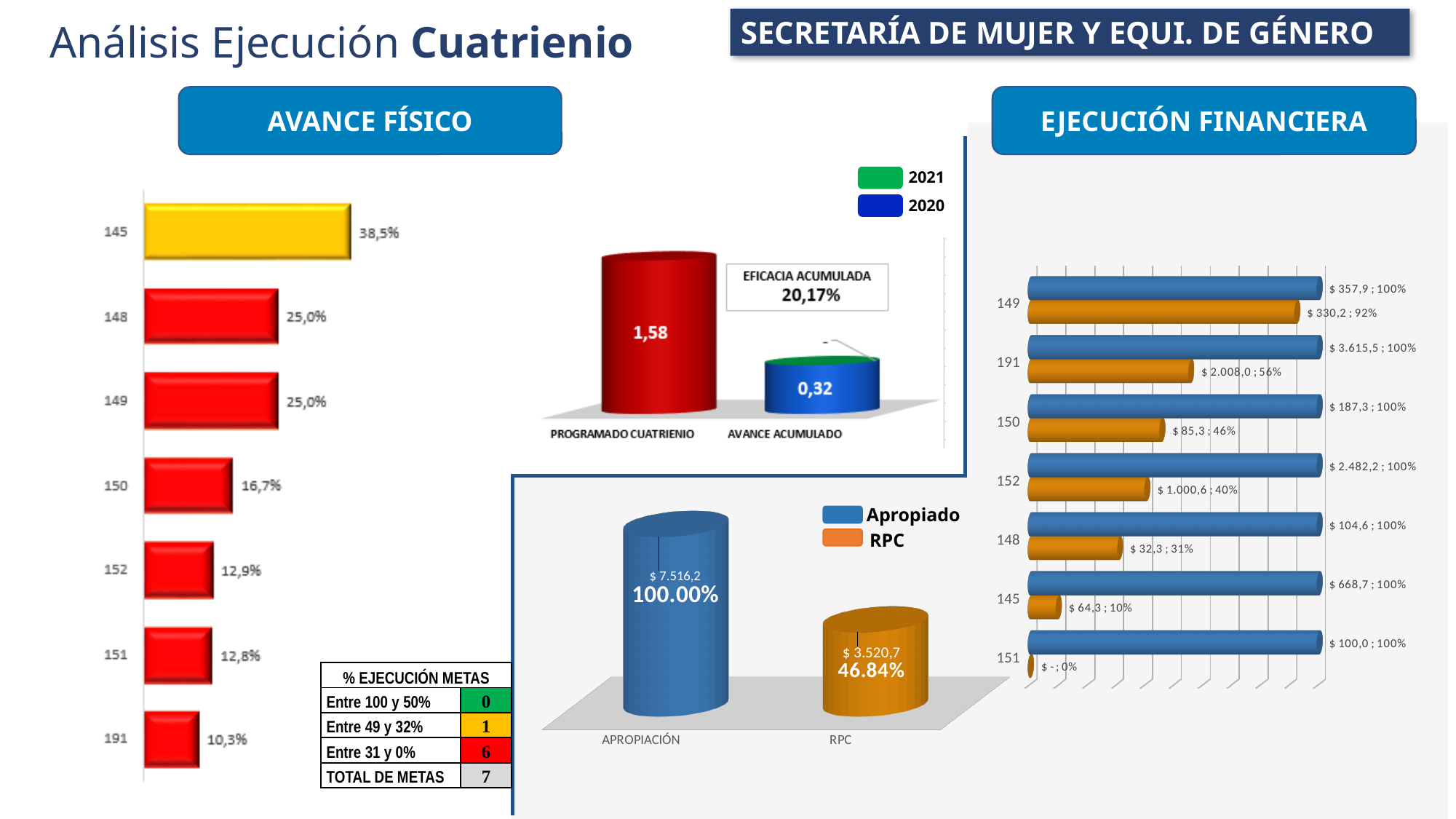
In the EJECUCIÓN FINANCIERA bar chart on the right, which category has the highest Apropiado value? 191 In the AVANCE FÍSICO bar chart on the left, what is the difference between the values for 145 and 150? 21,8% In the AVANCE FÍSICO bar chart on the left, which category has the lowest value? 191 In the APROPIACIÓN / RPC chart at the bottom middle, what is the value for RPC? $ 3.520,7 In the EJECUCIÓN FINANCIERA bar chart on the right, what is the RPC value for category 191? $ 2.008,0 In the APROPIACIÓN / RPC chart at the bottom middle, what percentage is shown for RPC? 46.84% In the PROGRAMADO CUATRIENIO / AVANCE ACUMULADO chart in the middle, what is the EFICACIA ACUMULADA shown? 20,17% In the EJECUCIÓN FINANCIERA bar chart on the right, how many series does the legend list? 2 In the PROGRAMADO CUATRIENIO / AVANCE ACUMULADO chart in the middle, what is the value for AVANCE ACUMULADO? 0,32 In the AVANCE FÍSICO bar chart on the left, what is the value for category 145? 38,5% In the AVANCE FÍSICO bar chart on the left, how many categories are shown? 7 What kind of chart is the AVANCE FÍSICO chart on the left? Bar chart